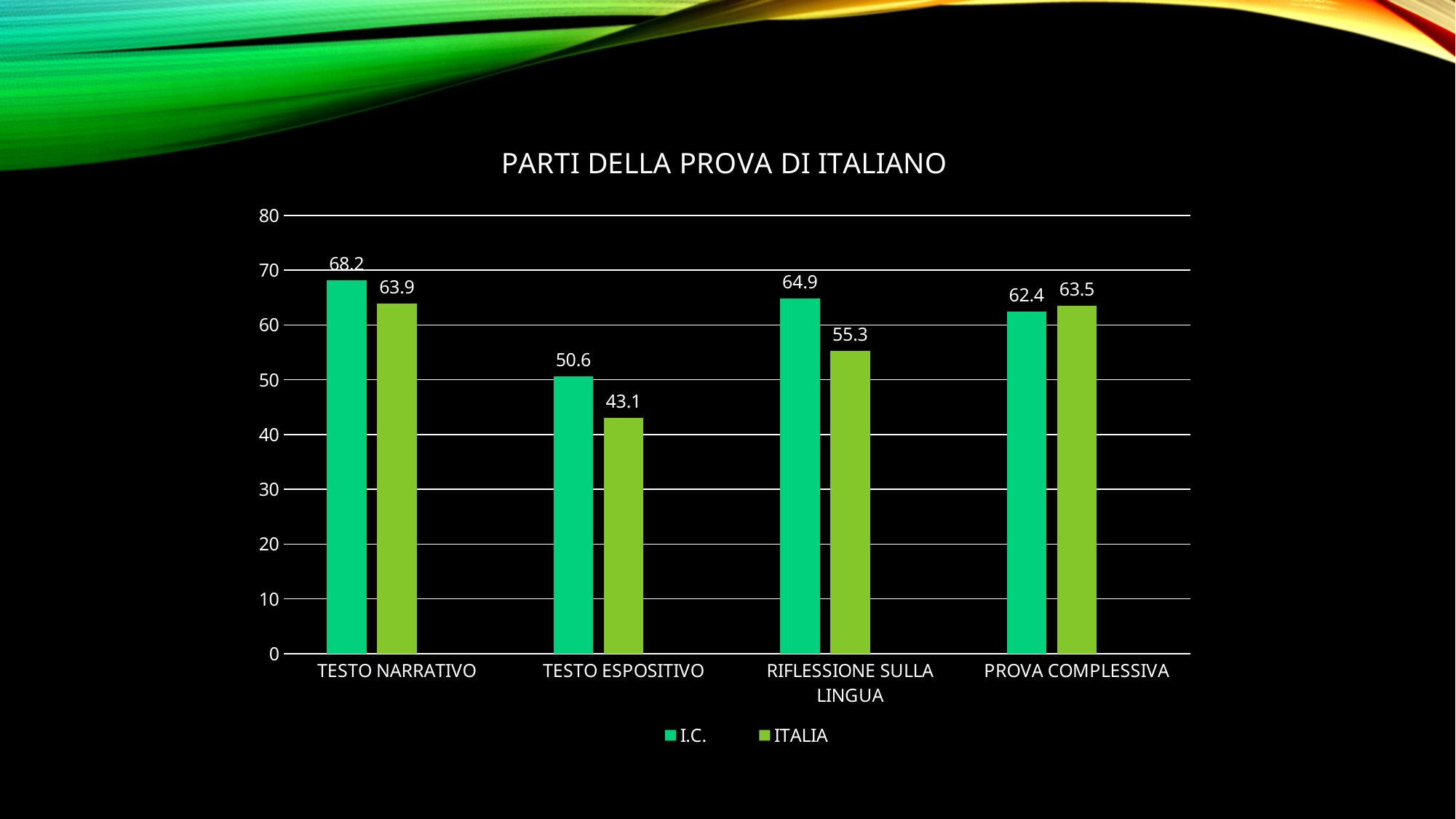
Which category has the lowest ITALIA value? TESTO ESPOSITIVO Which is larger for PROVA COMPLESSIVA, the I.C. value or the ITALIA value? ITALIA What is the title of the chart? PARTI DELLA PROVA DI ITALIANO What kind of chart is shown on the slide? Bar chart What is the ITALIA value for RIFLESSIONE SULLA LINGUA? 55.3 What is the ITALIA value for TESTO ESPOSITIVO? 43.1 What is the I.C. value for PROVA COMPLESSIVA? 62.4 How many categories are shown on the x axis? 4 How many series does the legend list? 2 What is the difference between the I.C. and ITALIA values for RIFLESSIONE SULLA LINGUA? 9.6 Which category has the highest I.C. value? TESTO NARRATIVO What is the I.C. value for TESTO NARRATIVO? 68.2